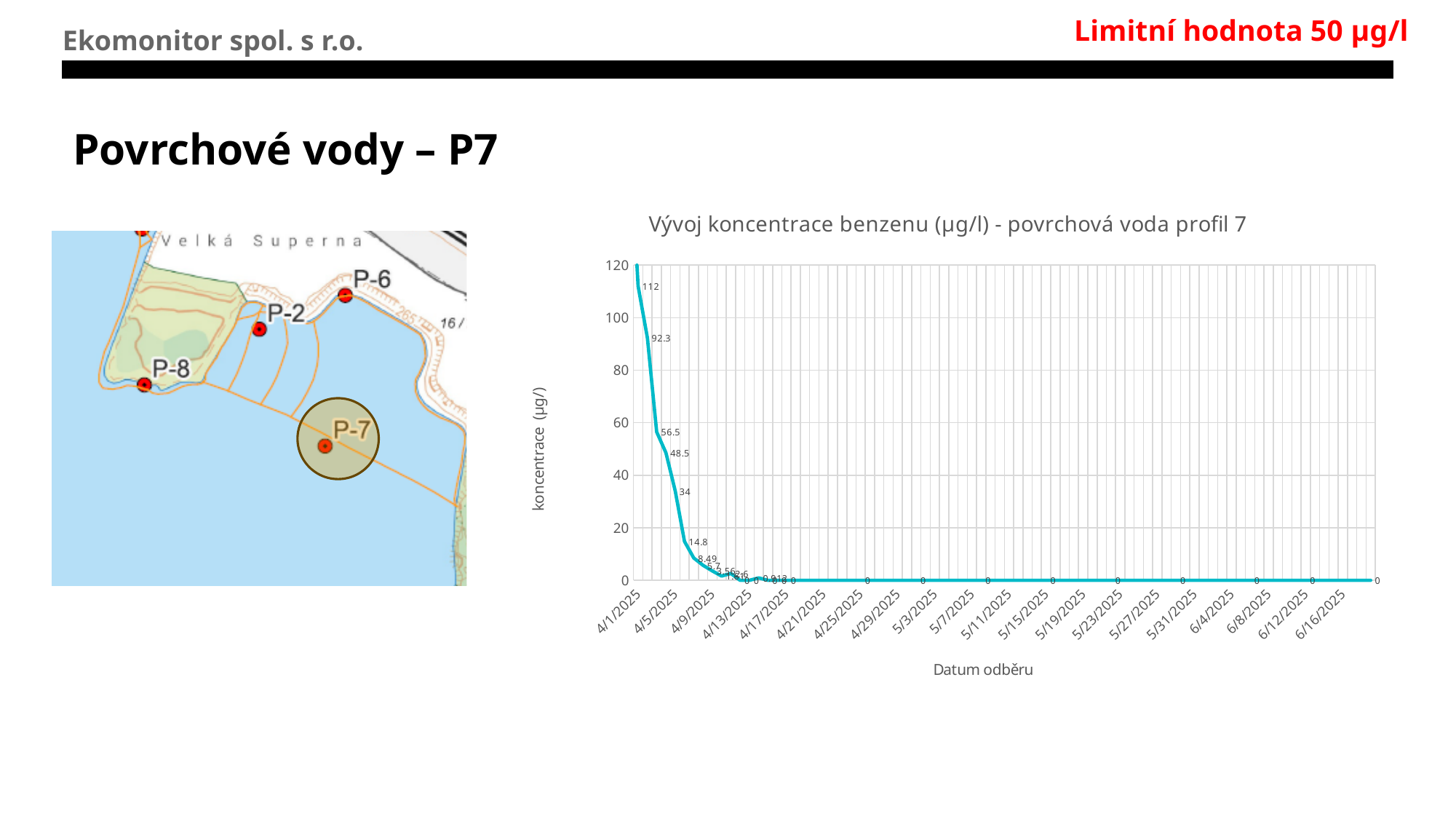
What is the benzene concentration value at 4/1/2025? 112 What is the label of the x axis of the chart? Datum odběru What is the lowest value plotted on the chart? 0 Do the values rise or fall along the x axis from 4/1/2025 onward? fall What kind of chart is shown on the slide? line chart Which is larger, the value labelled 56.5 or the value labelled 48.5? 56.5 Is the value at 5/15/2025 greater or less than 20? less What is the highest value plotted on the chart? 112 What is the difference between the first two labelled values, 112 and 92.3? 19.7 Is the value at 4/1/2025 greater or less than 100? greater What is the title of the chart? Vývoj koncentrace benzenu (µg/l) - povrchová voda profil 7